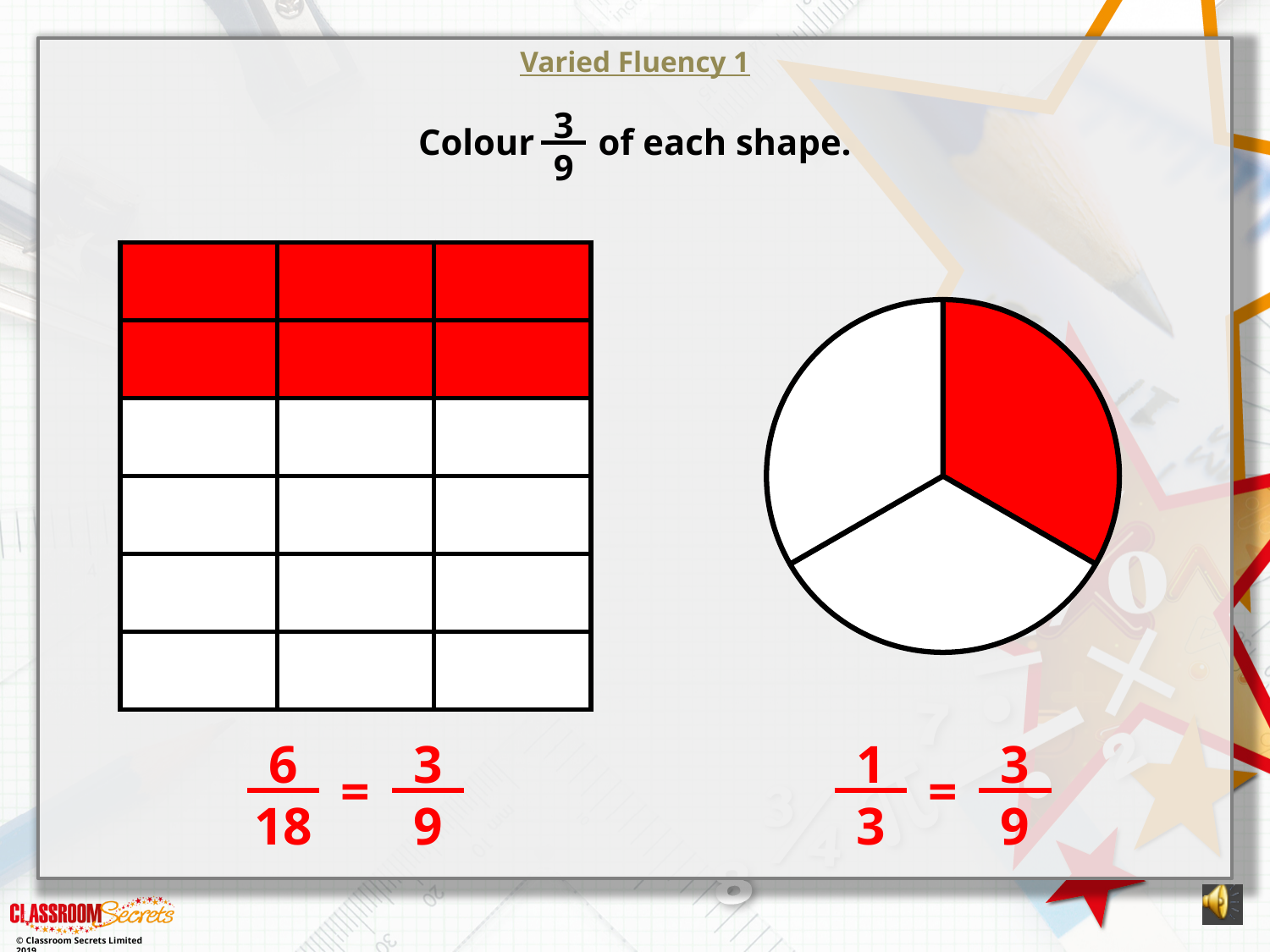
What fraction is printed below the grid on the left as equal to 3/9? 6/18 What fraction of the circle is shown as coloured, according to the fraction printed below it? 1/3 Is the coloured part of the circle greater or less than half of the circle? less How many of the circle's parts are coloured red? 1 Which shape has more coloured parts, the grid on the left or the circle on the right? the grid on the left What fraction is printed below the circle on the right as equal to 3/9? 1/3 How many rows of the grid on the left are fully coloured red? 2 What is the title of the slide? Varied Fluency 1 How many equal parts is the circle on the right divided into? 3 What fraction of each shape does the instruction ask to colour? 3/9